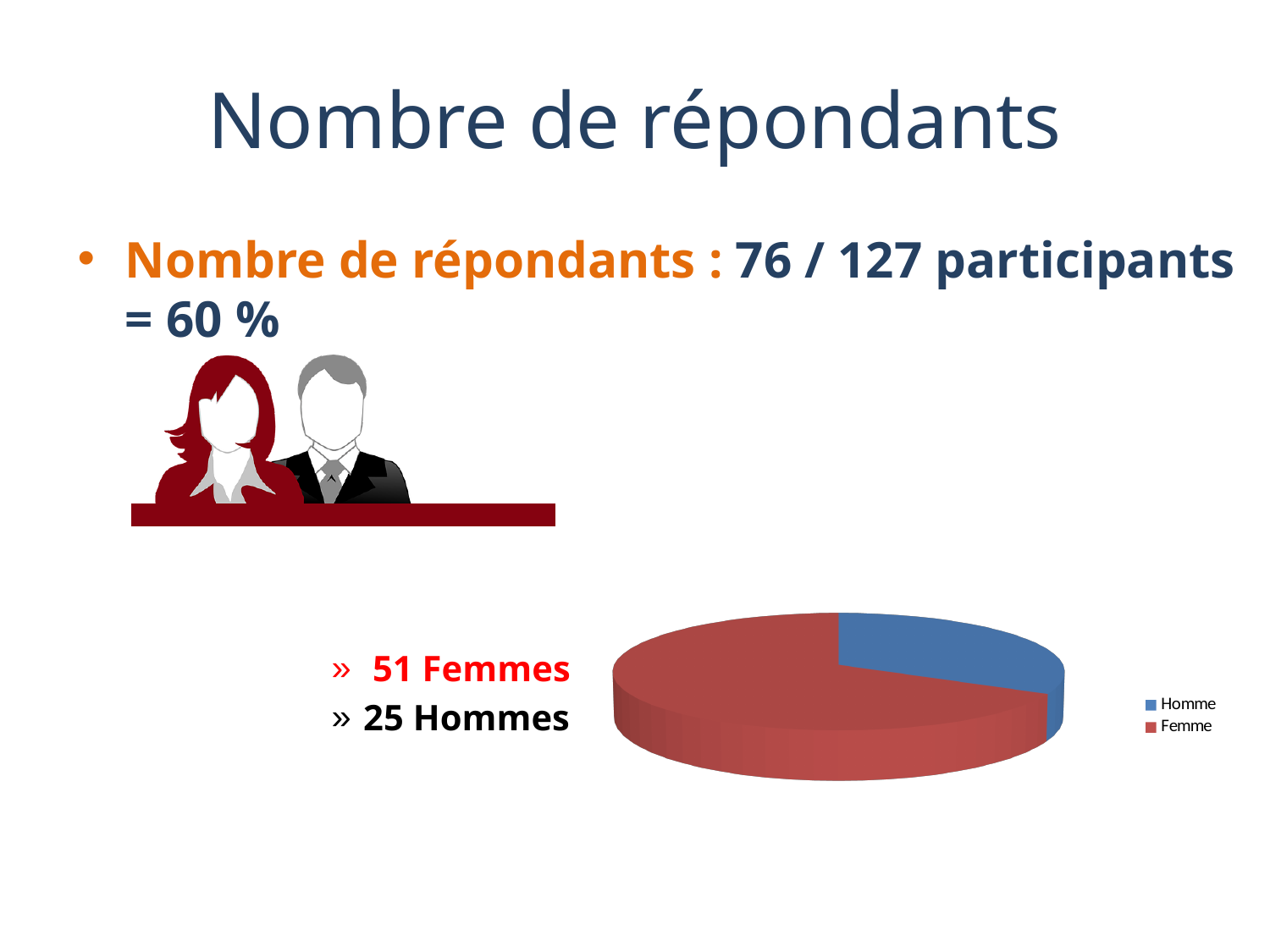
According to the slide, how many respondents are women (Femmes)? 51 Which category has the largest slice in the pie chart? Femme What is the total number of respondents represented in the pie chart? 76 How many slices does the pie chart have? 2 Which category has the smallest slice in the pie chart? Homme What colour is the Homme slice in the pie chart? blue Which slice is larger in the pie chart, Homme or Femme? Femme How many entries does the legend of the pie chart list? 2 What colour is the Femme slice in the pie chart? red What kind of chart is shown on the slide? pie chart What is the difference between the number of Femmes and the number of Hommes shown on the slide? 26 According to the slide, how many respondents are men (Hommes)? 25